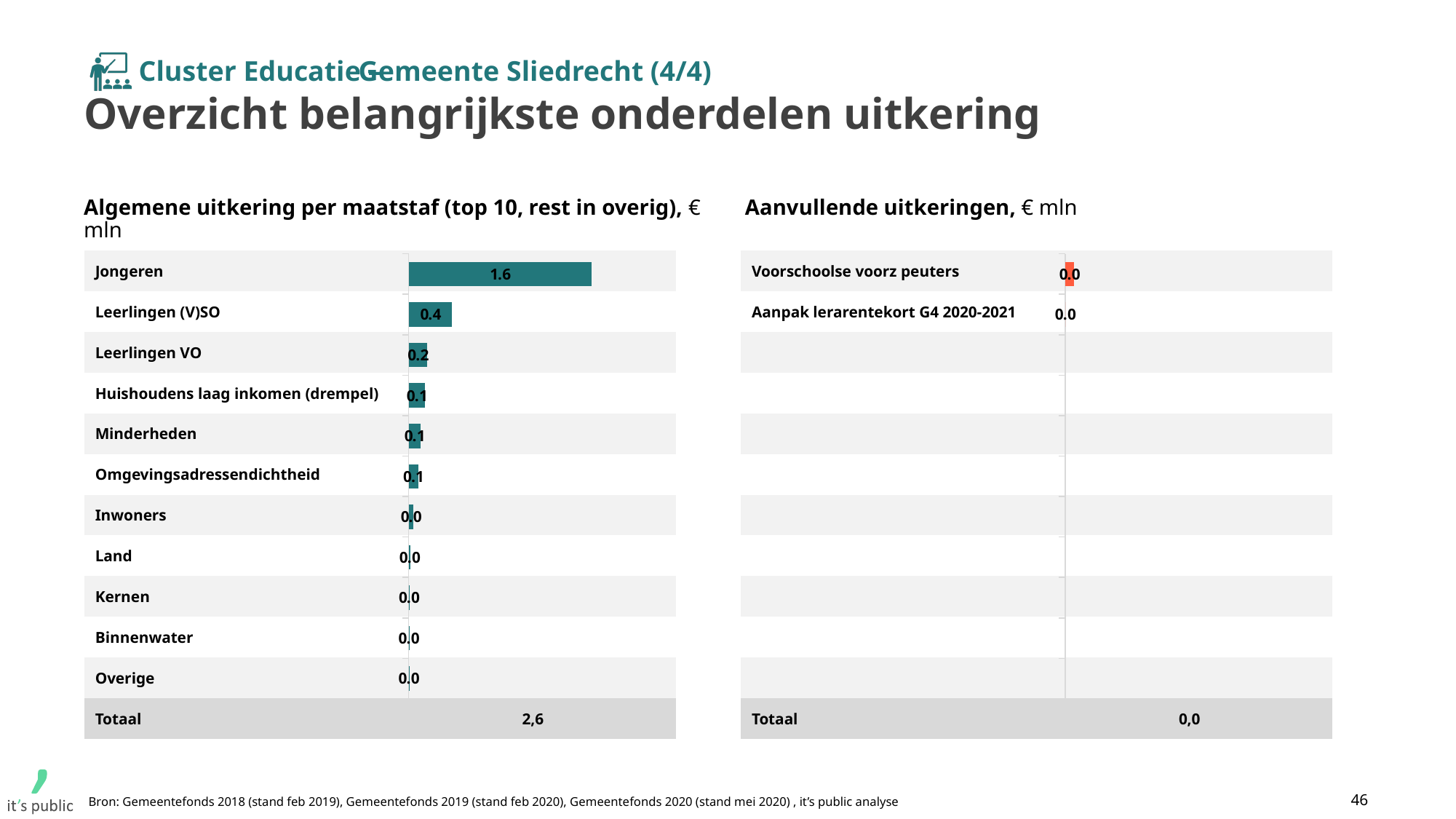
In the 'Aanvullende uitkeringen' chart, what is the value for Aanpak lerarentekort G4 2020-2021? 0.0 What is the Totaal shown for the 'Aanvullende uitkeringen' chart? 0,0 In the 'Algemene uitkering per maatstaf' chart, what is the value for Leerlingen (V)SO? 0.4 What is the Totaal shown for the 'Algemene uitkering per maatstaf' chart? 2,6 In the 'Algemene uitkering per maatstaf' chart, which is larger: Leerlingen (V)SO or Leerlingen VO? Leerlingen (V)SO What kind of chart is the 'Algemene uitkering per maatstaf' chart? Bar chart In the 'Algemene uitkering per maatstaf' chart, which category has the highest value? Jongeren In the 'Algemene uitkering per maatstaf' chart, what is the value for Leerlingen VO? 0.2 In the 'Algemene uitkering per maatstaf' chart, what is the value for Jongeren? 1.6 How many categories are shown in the 'Algemene uitkering per maatstaf' chart, excluding the Totaal row? 11 In the 'Algemene uitkering per maatstaf' chart, what is the difference between Jongeren and Leerlingen (V)SO? 1.2 How many categories are shown in the 'Aanvullende uitkeringen' chart, excluding the Totaal row? 2